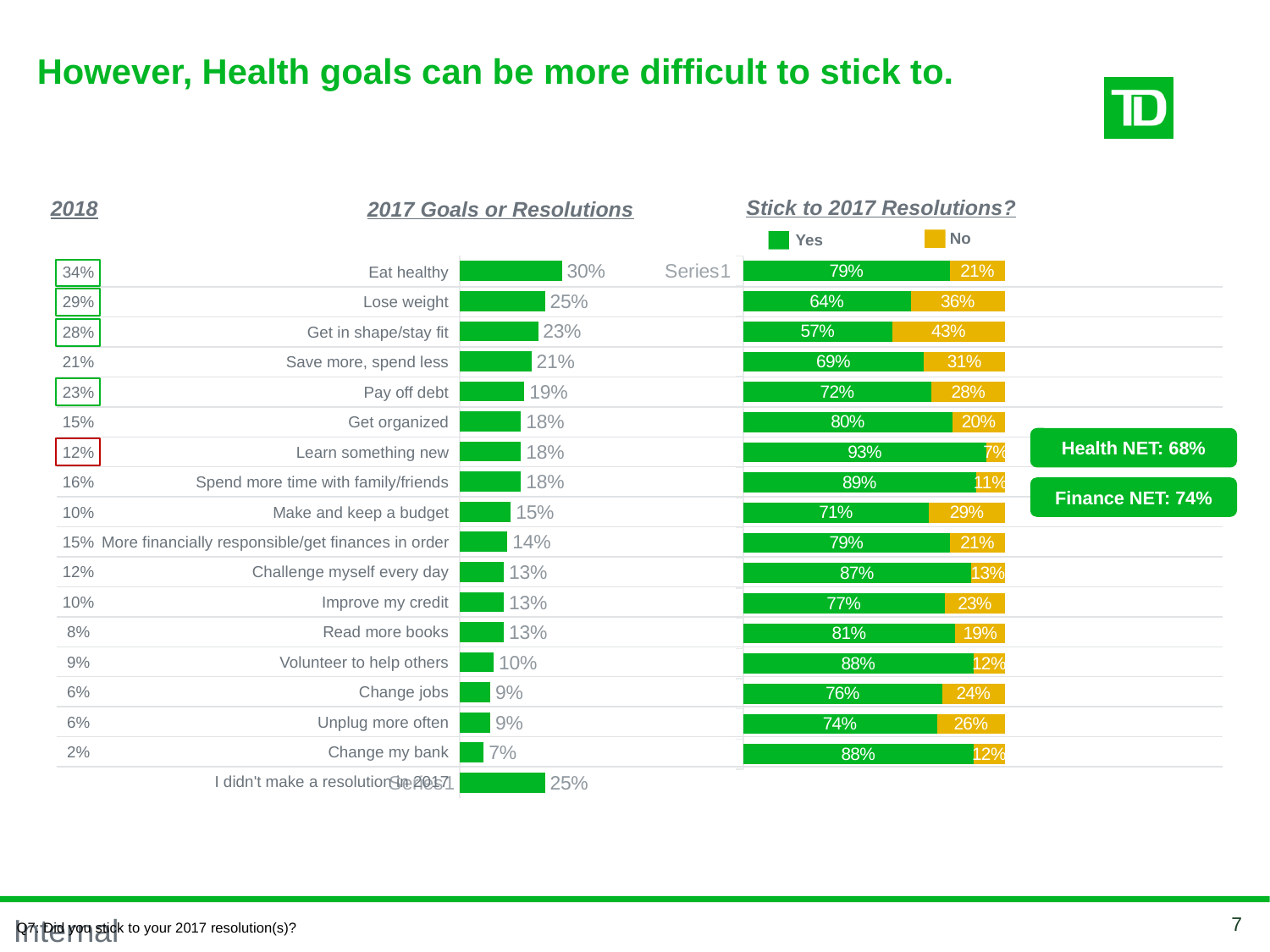
In the '2017 Goals or Resolutions' chart, what is the difference between Eat healthy and Lose weight? 5 percentage points In the 'Stick to 2017 Resolutions?' chart, which resolution has the lowest Yes value? Get in shape/stay fit In the 'Stick to 2017 Resolutions?' chart, what is the No value for Unplug more often? 26% In the '2017 Goals or Resolutions' chart, which goal has the lowest value? Change my bank In the 'Stick to 2017 Resolutions?' chart, which resolution has the highest Yes value? Learn something new In the 'Stick to 2017 Resolutions?' chart, what is the total of the Yes and No segments for Eat healthy? 100% What kind of chart is the '2017 Goals or Resolutions' chart? Bar chart In the 'Stick to 2017 Resolutions?' chart, which has the larger Yes value: Lose weight or Pay off debt? Pay off debt How many series does the legend of the 'Stick to 2017 Resolutions?' chart list? 2 In the '2017 Goals or Resolutions' chart, what is the value for Eat healthy? 30% How many resolutions are shown in the 'Stick to 2017 Resolutions?' chart? 17 In the 'Stick to 2017 Resolutions?' chart, what is the Yes value for Get in shape/stay fit? 57%